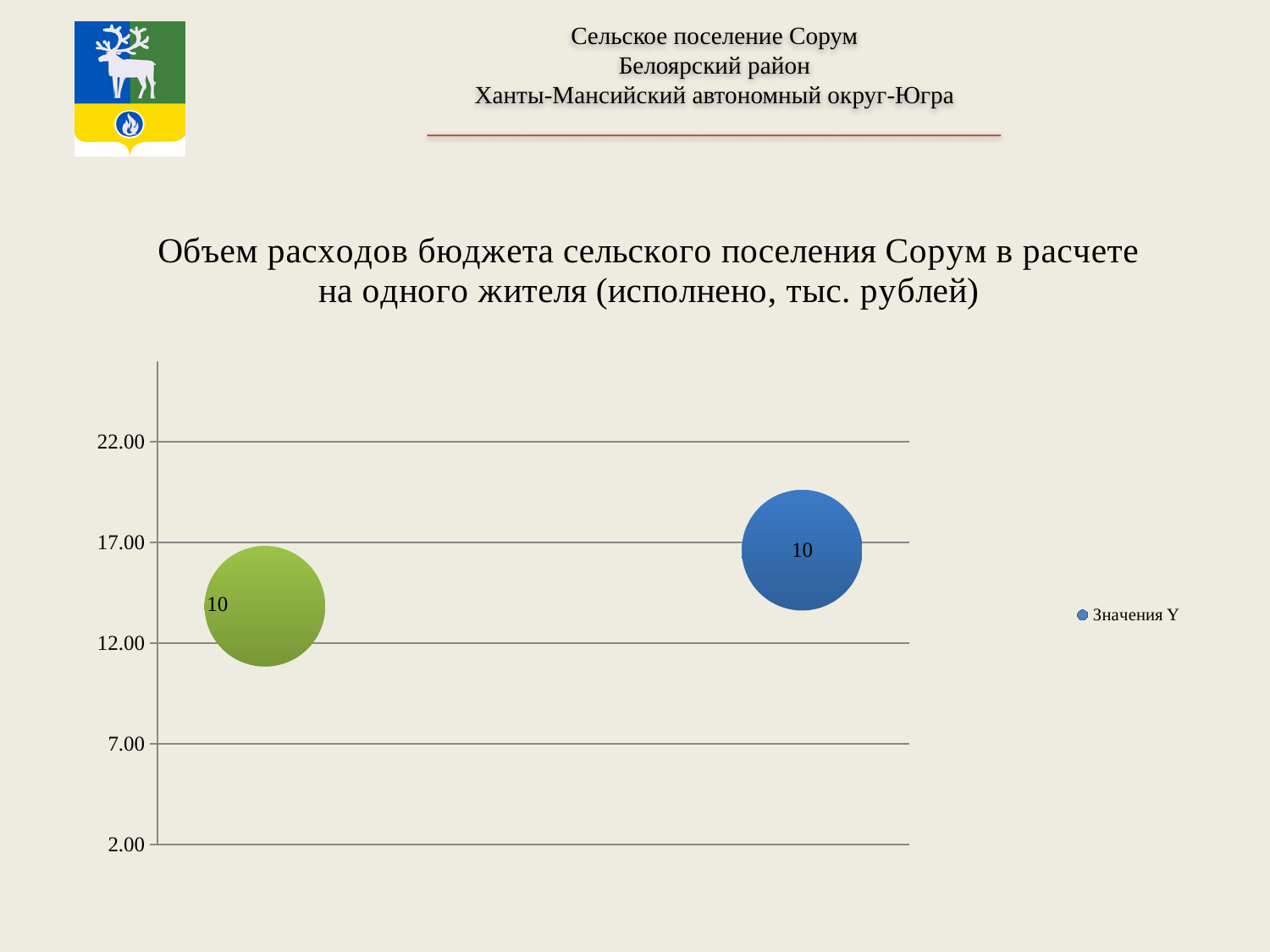
Is the vertical position of the green bubble greater or less than 12.00? greater Is the vertical position of the blue bubble greater or less than 12.00? greater What is the legend entry shown on the chart? Значения Y Which bubble is positioned higher on the vertical axis, the green one or the blue one? The blue one How many series does the legend list? 1 Is the vertical position of the blue bubble greater or less than 22.00? less What data label is printed on the blue bubble? 10 What kind of chart is shown on the slide? Bubble chart What data label is printed on the green bubble? 10 What is the lowest value shown on the vertical axis? 2.00 What is the title of the chart? Объем расходов бюджета сельского поселения Сорум в расчете на одного жителя (исполнено, тыс. рублей) How many bubbles are plotted on the chart? 2